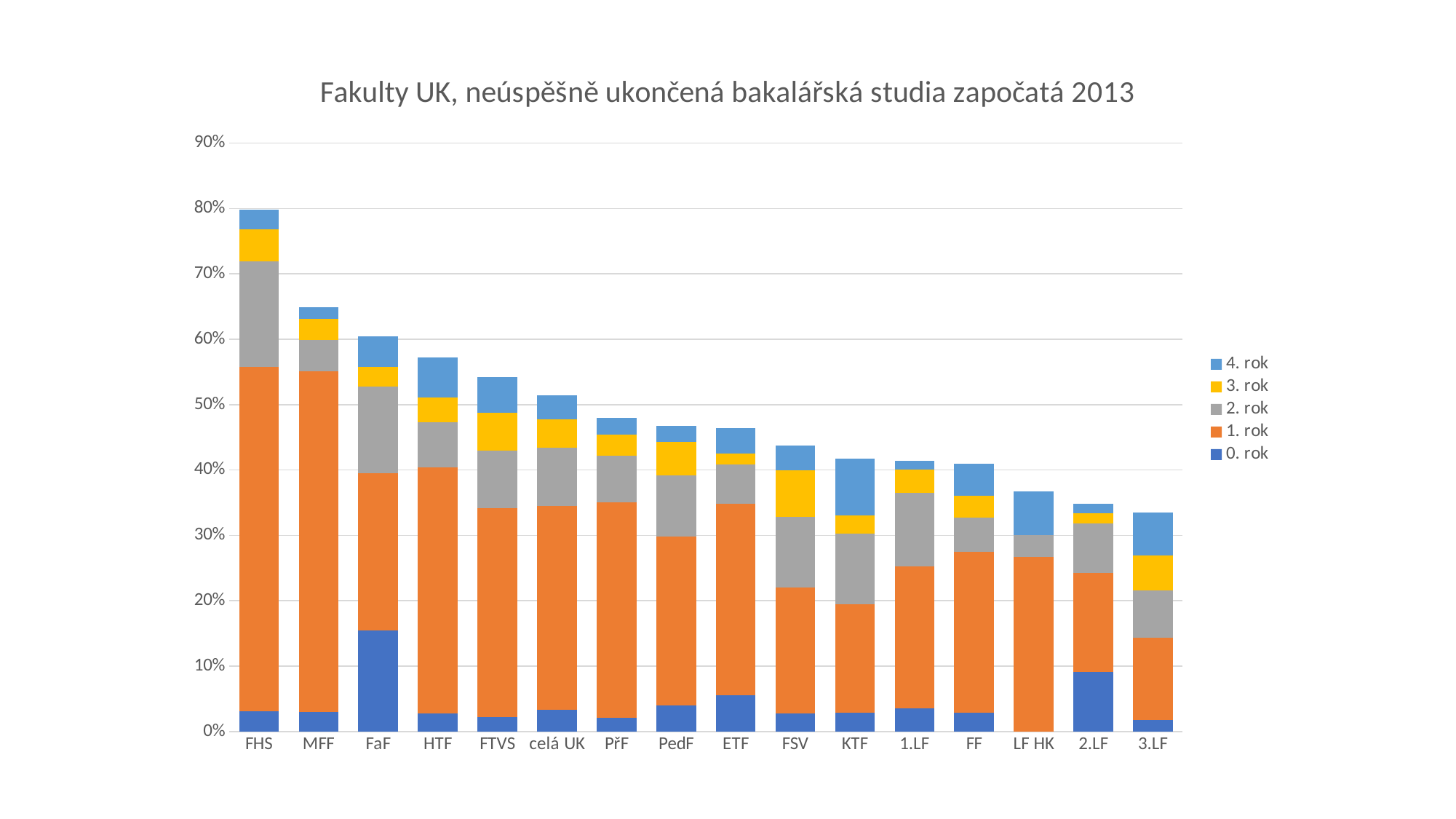
How many series does the legend list? 5 Is the total bar for HTF greater or less than 50%? greater How many faculties/categories are shown on the x axis? 16 Is the total bar for LF HK greater or less than 40%? less What kind of chart is shown on the slide? stacked bar chart Is the total bar for MFF greater or less than 60%? greater Do the total bar heights rise or fall from left to right along the x axis? fall What is the title of the chart? Fakulty UK, neúspěšně ukončená bakalářská studia započatá 2013 Which has the larger total bar, FHS or MFF? FHS Which category has the largest '0. rok' segment? FaF Which category has the highest total bar? FHS Which category has the lowest total bar? 3.LF